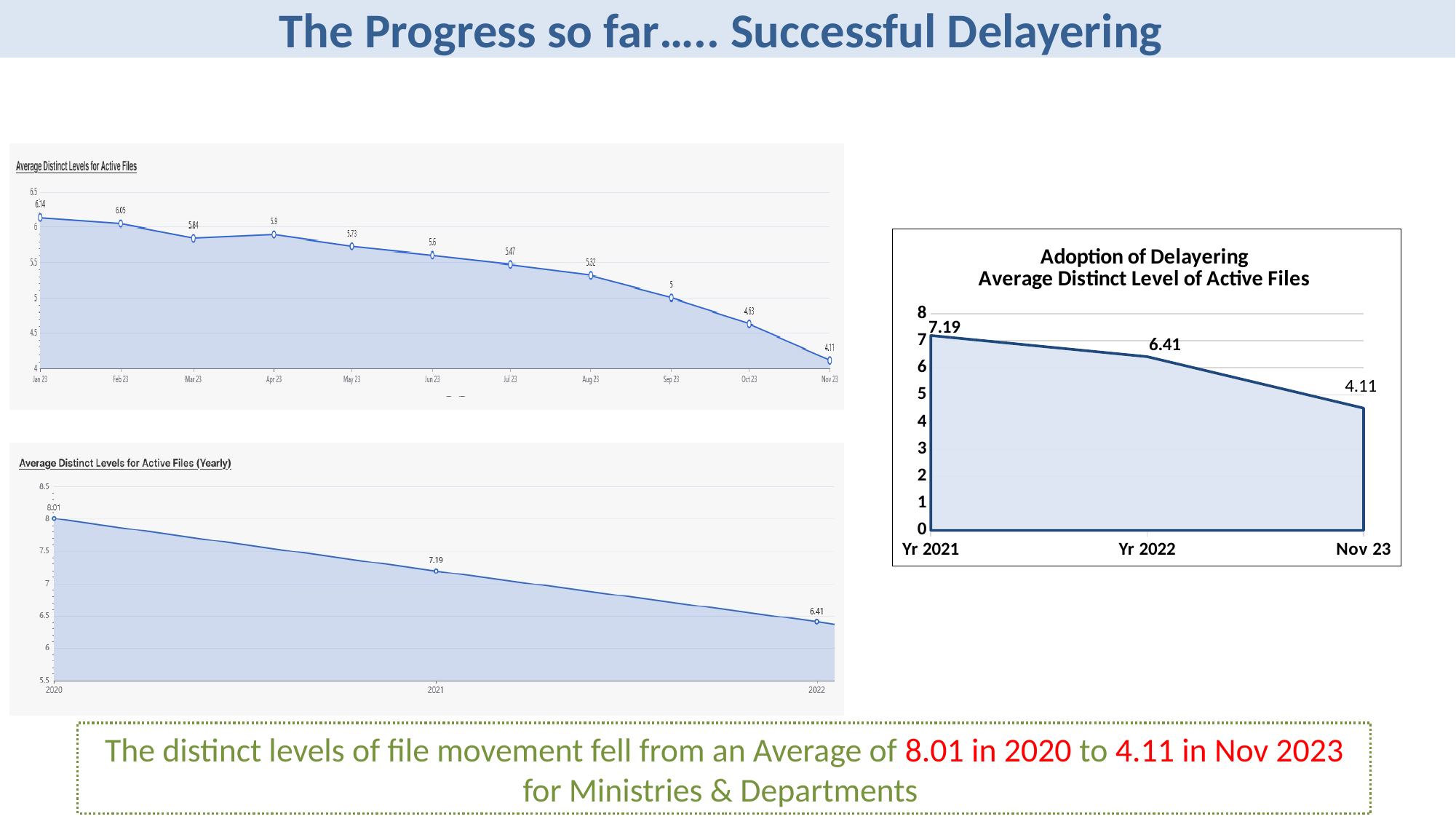
What kind of chart is the right chart 'Adoption of Delayering'? area chart In the right chart 'Adoption of Delayering', what is the value for Nov 23? 4.11 In the top-left chart 'Average Distinct Levels for Active Files', what is the value for Jan 23? 6.14 In the right chart 'Adoption of Delayering', which is larger, the value for Yr 2021 or Yr 2022? Yr 2021 In the top-left chart 'Average Distinct Levels for Active Files', which month has the lowest value? Nov 23 In the top-left chart 'Average Distinct Levels for Active Files', how many months are plotted? 11 In the top-left chart 'Average Distinct Levels for Active Files', what is the difference between the Jan 23 and Nov 23 values? 2.03 In the bottom-left chart 'Average Distinct Levels for Active Files (Yearly)', what is the value for 2020? 8.01 In the bottom-left chart 'Average Distinct Levels for Active Files (Yearly)', what is the difference between the 2021 and 2022 values? 0.78 In the top-left chart 'Average Distinct Levels for Active Files', do the values generally rise or fall from Jan 23 to Nov 23? fall In the top-left chart 'Average Distinct Levels for Active Files', what is the value for Sep 23? 5 In the bottom-left chart 'Average Distinct Levels for Active Files (Yearly)', which year has the highest value? 2020